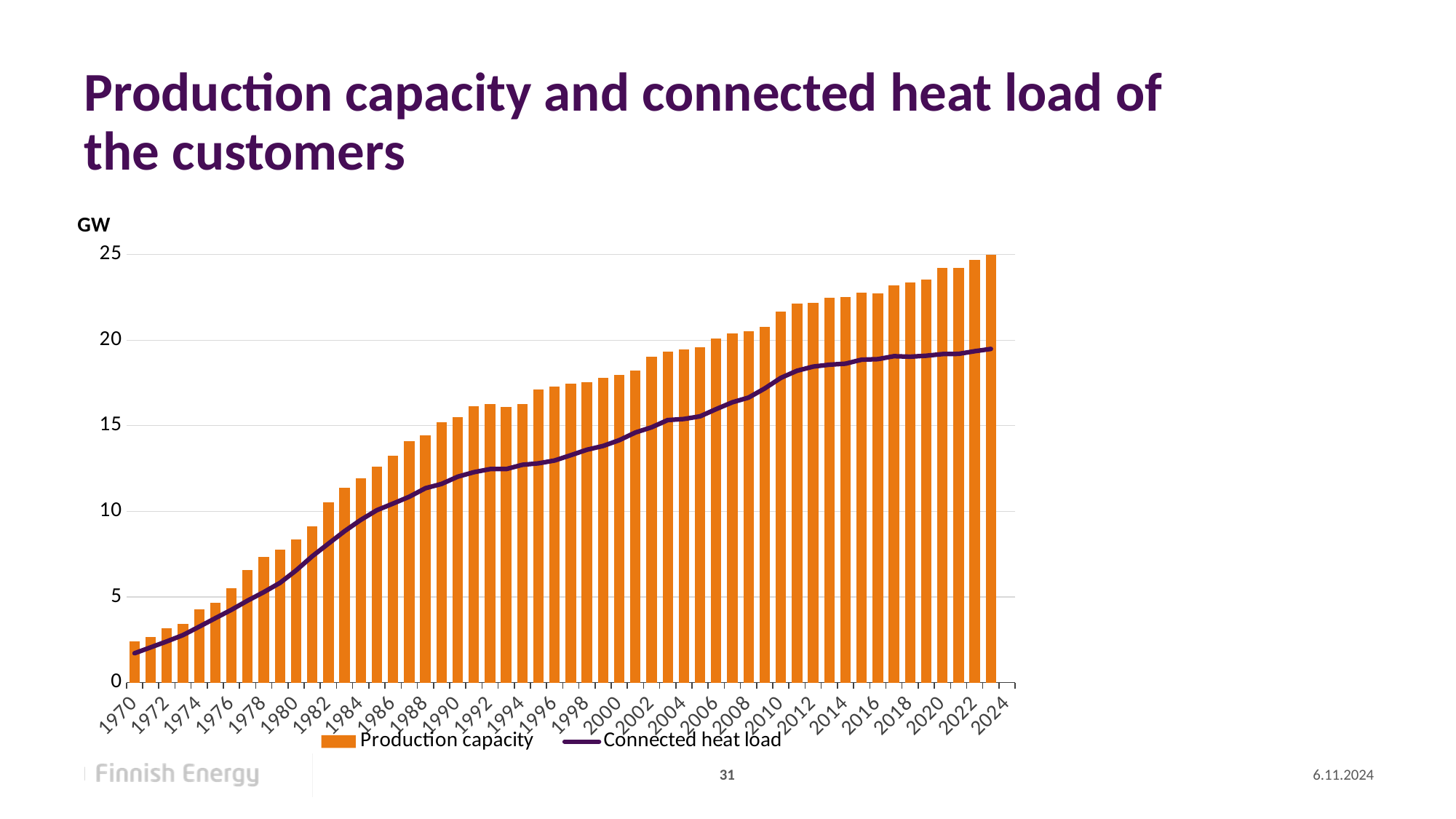
Is the production capacity in 2010 greater or less than 20 GW? greater In which year is production capacity lowest? 1970 What unit is shown on the vertical axis? GW Is the production capacity in 1980 greater or less than 10 GW? less What kind of chart is shown on the slide? A bar chart combined with a line chart How many series does the legend list? 2 In which year is production capacity highest? 2023 Does production capacity generally rise or fall from 1970 to 2024? Rise Is the connected heat load in 1990 greater or less than 10 GW? greater What are the two series named in the legend? Production capacity and Connected heat load